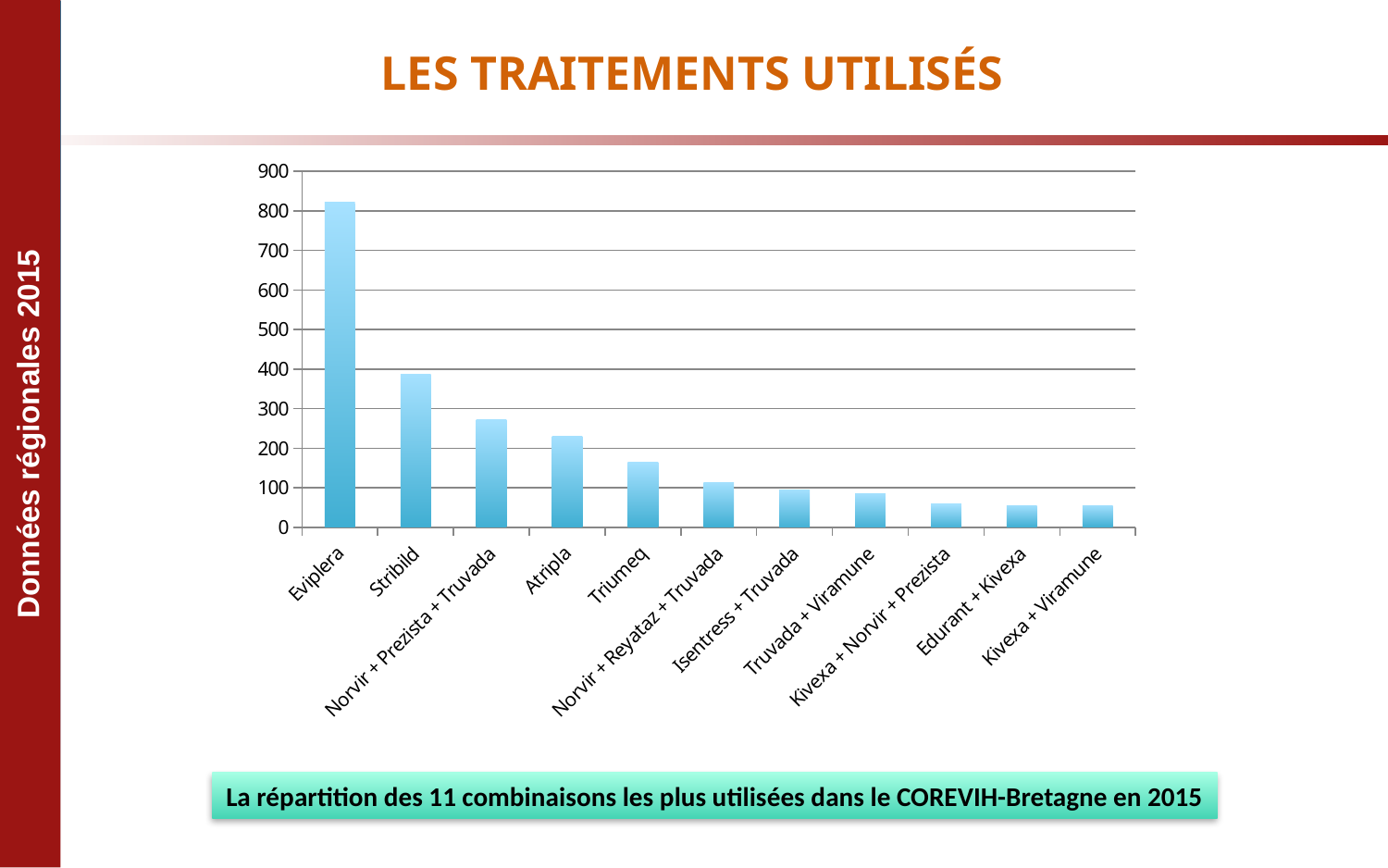
Which has a larger value, Stribild or Atripla? Stribild Do the values rise or fall from left to right along the x axis? fall How many treatment combinations are shown on the x axis? 11 Is the value for Eviplera greater or less than 800? greater Is the value for Stribild greater or less than 400? less Which treatment has the highest value? Eviplera Is the value for Atripla greater or less than 200? greater Which has a larger value, Triumeq or Truvada + Viramune? Triumeq What is the title of the slide containing the chart? LES TRAITEMENTS UTILISÉS What kind of chart is shown on the slide? bar chart